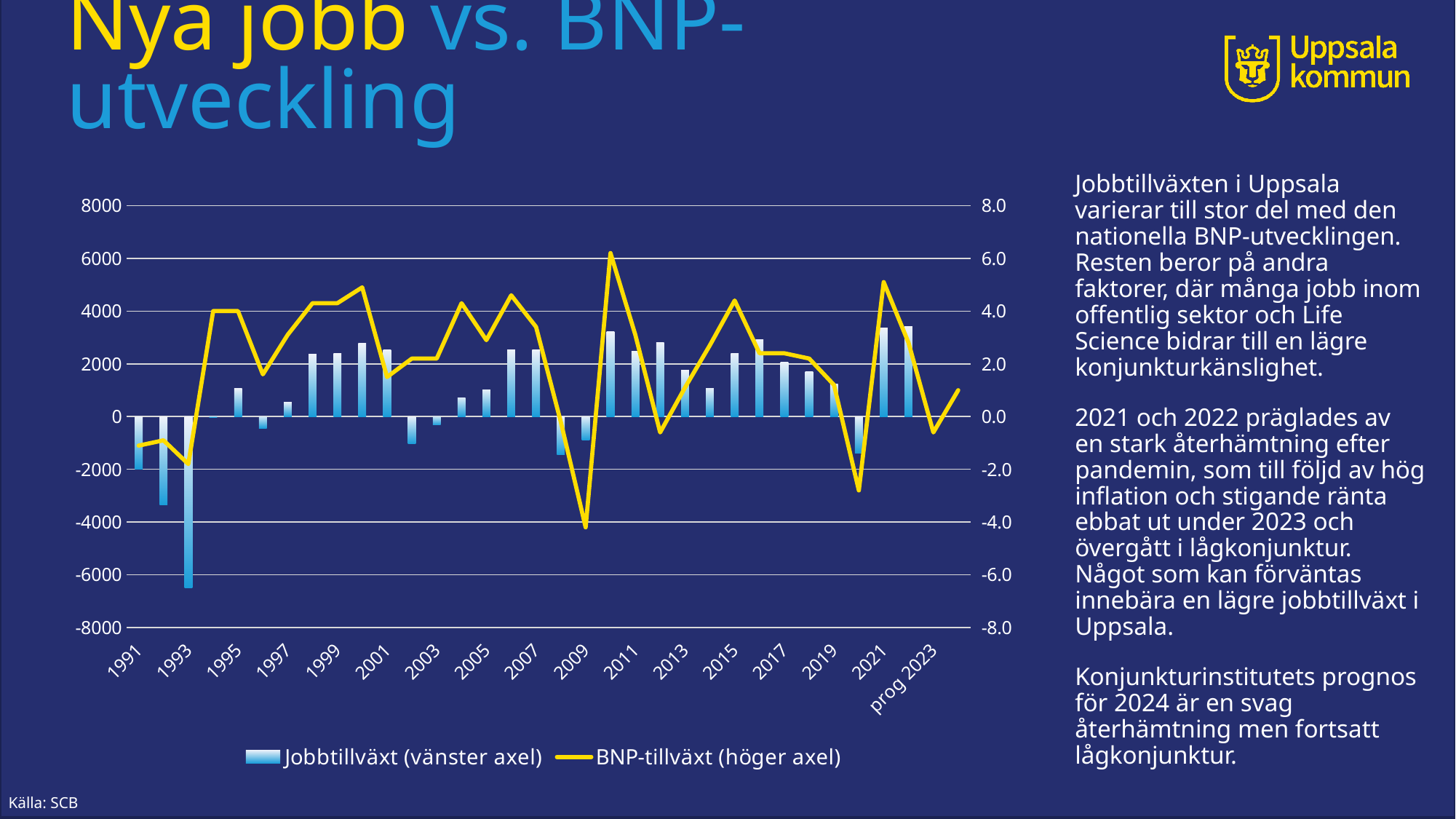
How many series does the chart legend list? 2 In which labelled year is the Jobbtillväxt bar lowest? 1993 What kind of chart is shown on the slide? A combined bar and line chart Which year has the larger Jobbtillväxt value, 1991 or 1993? 1991 What source is cited for the chart? SCB Is the BNP-tillväxt value for 2009 greater or less than -2.0? less Is the Jobbtillväxt value for 2021 greater or less than 2000? greater Is the Jobbtillväxt value for 1993 greater or less than -4000? less What are the two series named in the chart legend? Jobbtillväxt (vänster axel) and BNP-tillväxt (höger axel) Which year has the larger BNP-tillväxt value, 2009 or 2021? 2021